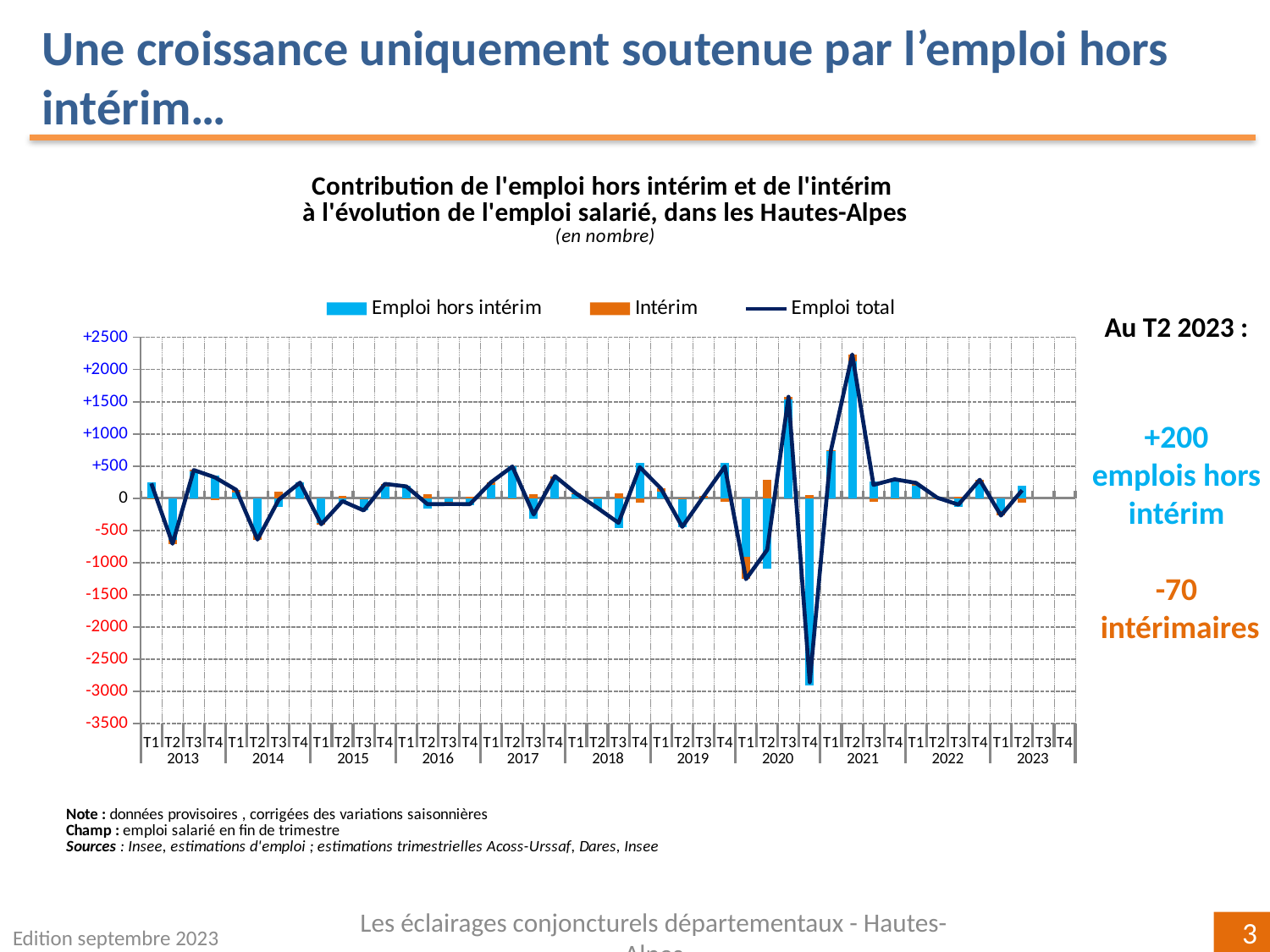
According to the slide, what is the value for Emploi hors intérim at T2 2023? +200 Is the value of Emploi total at T2 2021 greater or less than +2000? greater What kind of chart is shown on the slide? A combined bar and line chart In which quarter does the Emploi total line reach its lowest point? T4 2020 What are the three series named in the chart legend? Emploi hors intérim, Intérim, Emploi total According to the slide, what is the value for Intérim at T2 2023? -70 Is the value of Emploi hors intérim at T3 2020 greater or less than +1000? greater In which quarter does the Emploi total line reach its highest point? T2 2021 Is the value of Emploi total at T4 2020 greater or less than -2500? less How many series does the chart legend list? 3 Which is larger, the Emploi total value at T2 2021 or at T3 2020? T2 2021 How many years are shown along the x axis of the chart? 11